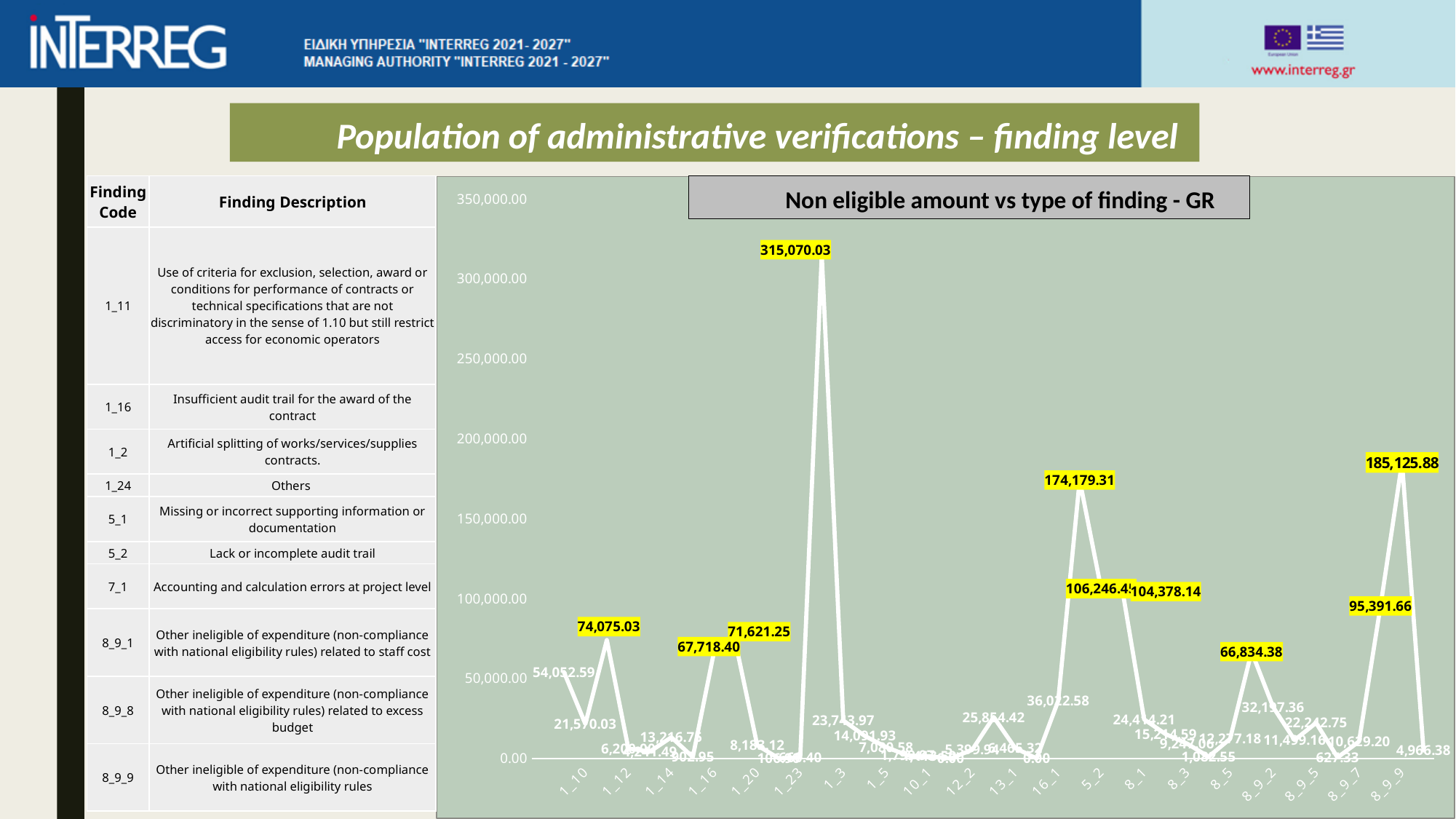
Is the highest point on the chart greater or less than 300,000.00? greater What is the difference between the highest labeled value (315,070.03) and the second-highest labeled value (185,125.88)? 129,944.15 What is the lowest value labeled on the chart? 0.00 What is the highest value labeled on the chart? 315,070.03 Which is larger, the labeled value 174,179.31 or the labeled value 185,125.88? 185,125.88 What is the highest tick value shown on the y axis? 350,000.00 What is the difference between the labeled values 174,179.31 and 104,378.14? 69,801.17 What is the second-highest value labeled on the chart? 185,125.88 What is the title of the chart? Non eligible amount vs type of finding - GR What type of chart is shown on the slide? line chart What is the difference between the labeled values 74,075.03 and 71,621.25? 2,453.78